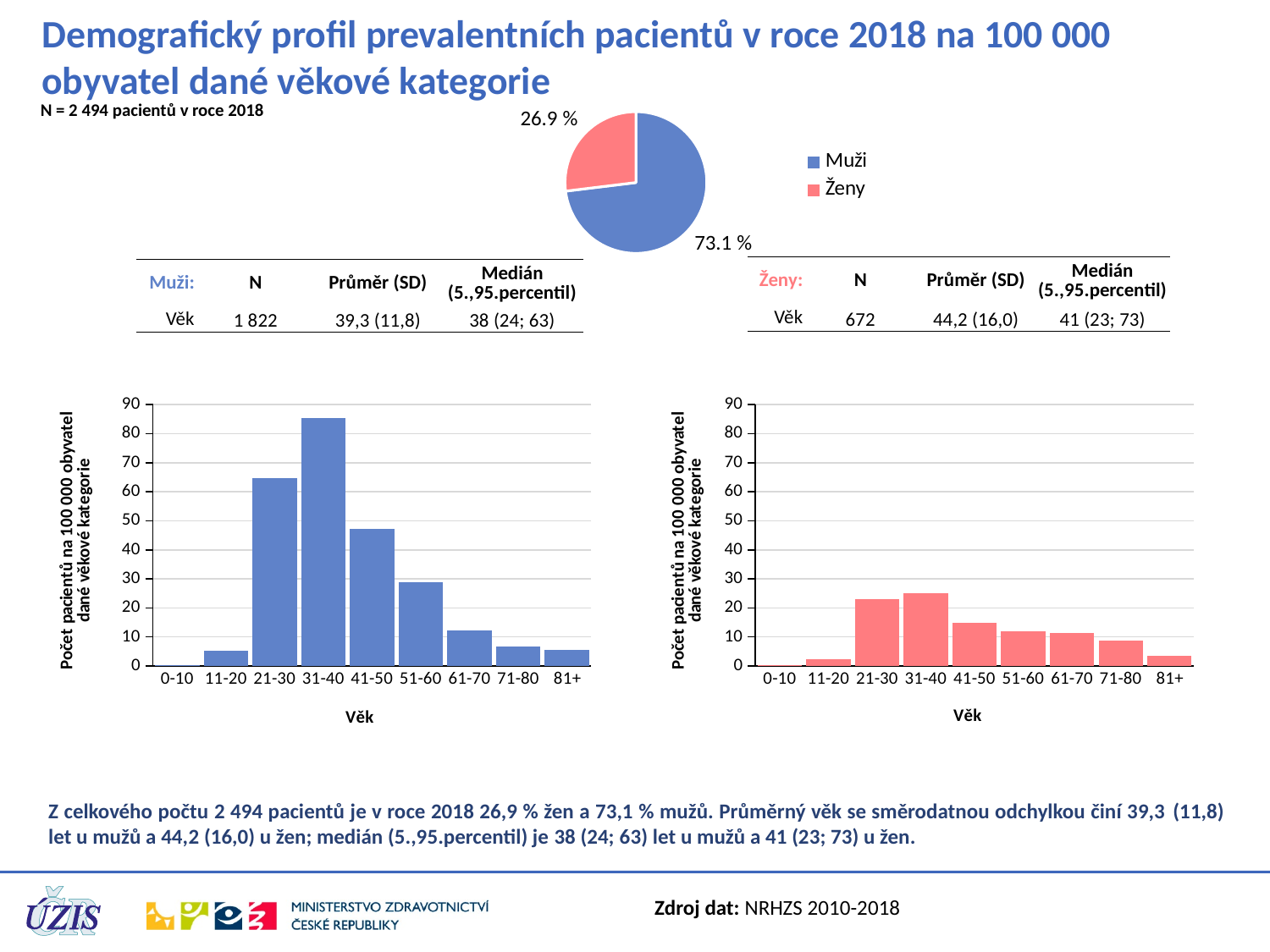
In the right-hand bar chart (women), do the values rise or fall from 31-40 to 81+? fall In the left-hand bar chart (men), which age category has the highest value? 31-40 What kind of chart is the chart at the top of the slide showing Muži and Ženy? pie chart In the pie chart, what share of patients are Muži (men)? 73.1 % In the left-hand bar chart (men), how many age categories are shown on the x axis? 9 In the left-hand bar chart (men), which age category has the lowest value? 0-10 In the right-hand bar chart (women), is the value for 31-40 greater or less than 20? greater In the pie chart, what share of patients are Ženy (women)? 26.9 % In the left-hand bar chart (men), is the value for 31-40 greater or less than 80? greater What kind of chart is the left-hand chart at the bottom of the slide (blue bars)? bar chart How many entries does the legend of the pie chart list? 2 In the left-hand bar chart (men), which is larger, the value for 21-30 or the value for 41-50? 21-30